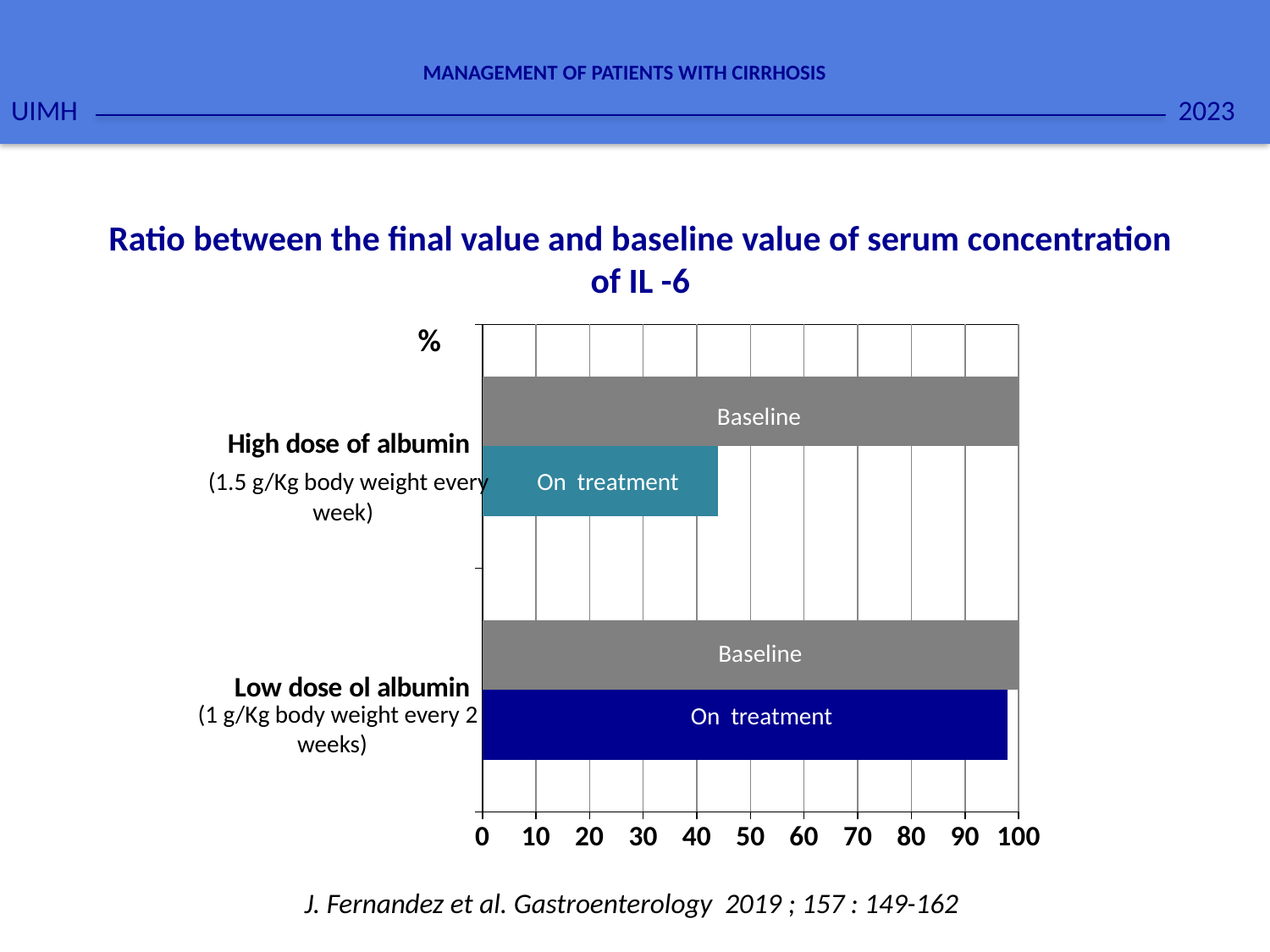
Is the On treatment value for High dose of albumin greater or less than 40? greater How many dose categories are shown on the chart? 2 What is the Baseline value for Low dose of albumin? 100 What is the highest value shown on the x axis? 100 What is the title of the chart? Ratio between the final value and baseline value of serum concentration of IL -6 Is the On treatment value for Low dose of albumin greater or less than 90? greater Which has the larger On treatment value, High dose of albumin or Low dose of albumin? Low dose of albumin What is the Baseline value for High dose of albumin? 100 Which bar on the chart is the shortest? On treatment for High dose of albumin What kind of chart is shown on the slide? bar chart Is the On treatment value for High dose of albumin greater or less than 50? less